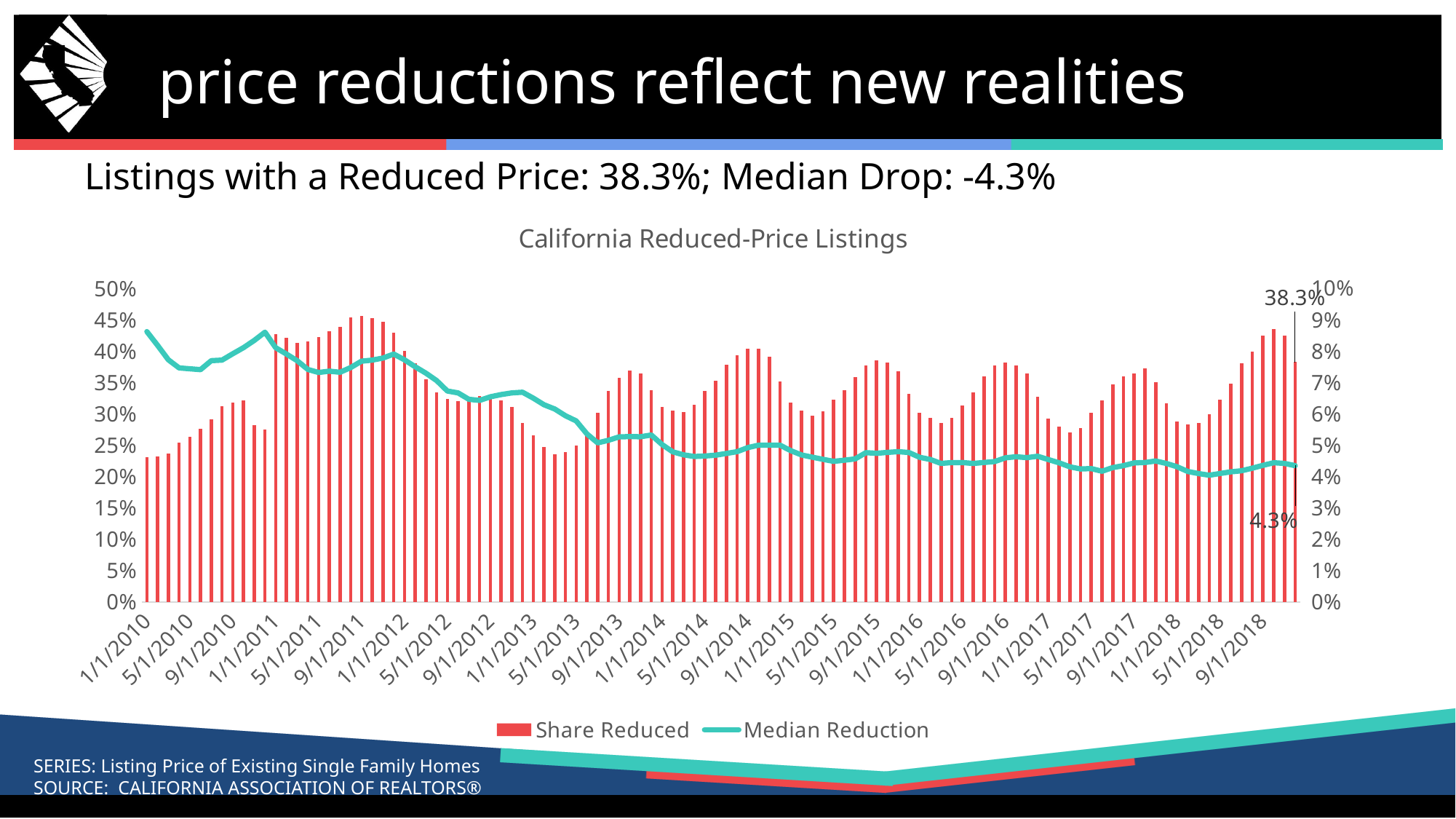
What is the labelled Median Reduction value at the most recent point on the chart? 4.3% Is the Median Reduction value for 5/1/2018 greater or less than 5%? less What kind of chart is shown on the slide? Combination bar and line chart Is the Share Reduced value for 5/1/2013 greater or less than 30%? less What is the title of the chart? California Reduced-Price Listings Overall, does the Median Reduction line rise or fall from 1/1/2010 to the end of the chart? fall Is the Share Reduced value for 9/1/2011 greater or less than 40%? greater What is the labelled Share Reduced value for the most recent bar on the chart? 38.3% What are the two series named in the legend? Share Reduced and Median Reduction How many series does the chart legend list? 2